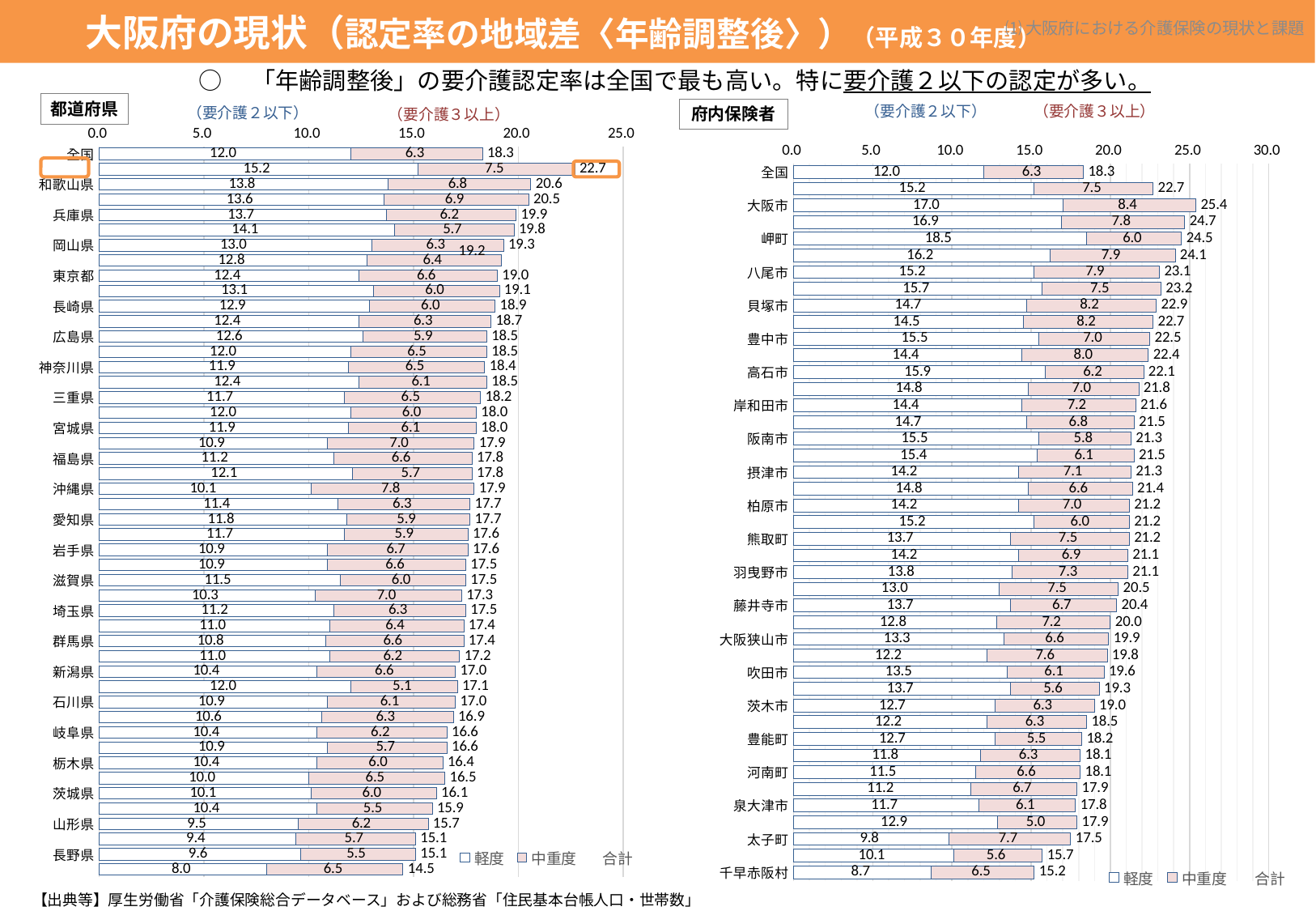
In the 府内保険者 chart on the right, what is the total (合計) value for 大阪市? 25.4 In the 府内保険者 chart on the right, what is the 軽度 value for 岬町? 18.5 In the 都道府県 chart on the left, what is the 軽度 value for 長野県? 9.6 In the 都道府県 chart on the left, what is the difference between the total for 和歌山県 and the total for 全国? 2.3 In the 府内保険者 chart on the right, which labeled insurer has the highest total? 大阪市 In the 府内保険者 chart on the right, which has the larger total, 貝塚市 or 豊中市? 貝塚市 In the 都道府県 chart on the left, what is the 中重度 value for 和歌山県? 6.8 In the 府内保険者 chart on the right, do the total values rise or fall going from the top bar to the bottom bar? fall What kind of chart is the 都道府県 chart on the left? bar chart In the 府内保険者 chart on the right, which labeled insurer has the lowest total? 千早赤阪村 How many entries does the legend of the 府内保険者 chart on the right list? 3 In the 府内保険者 chart on the right, what is the total of the stacked bar for 太子町? 17.5